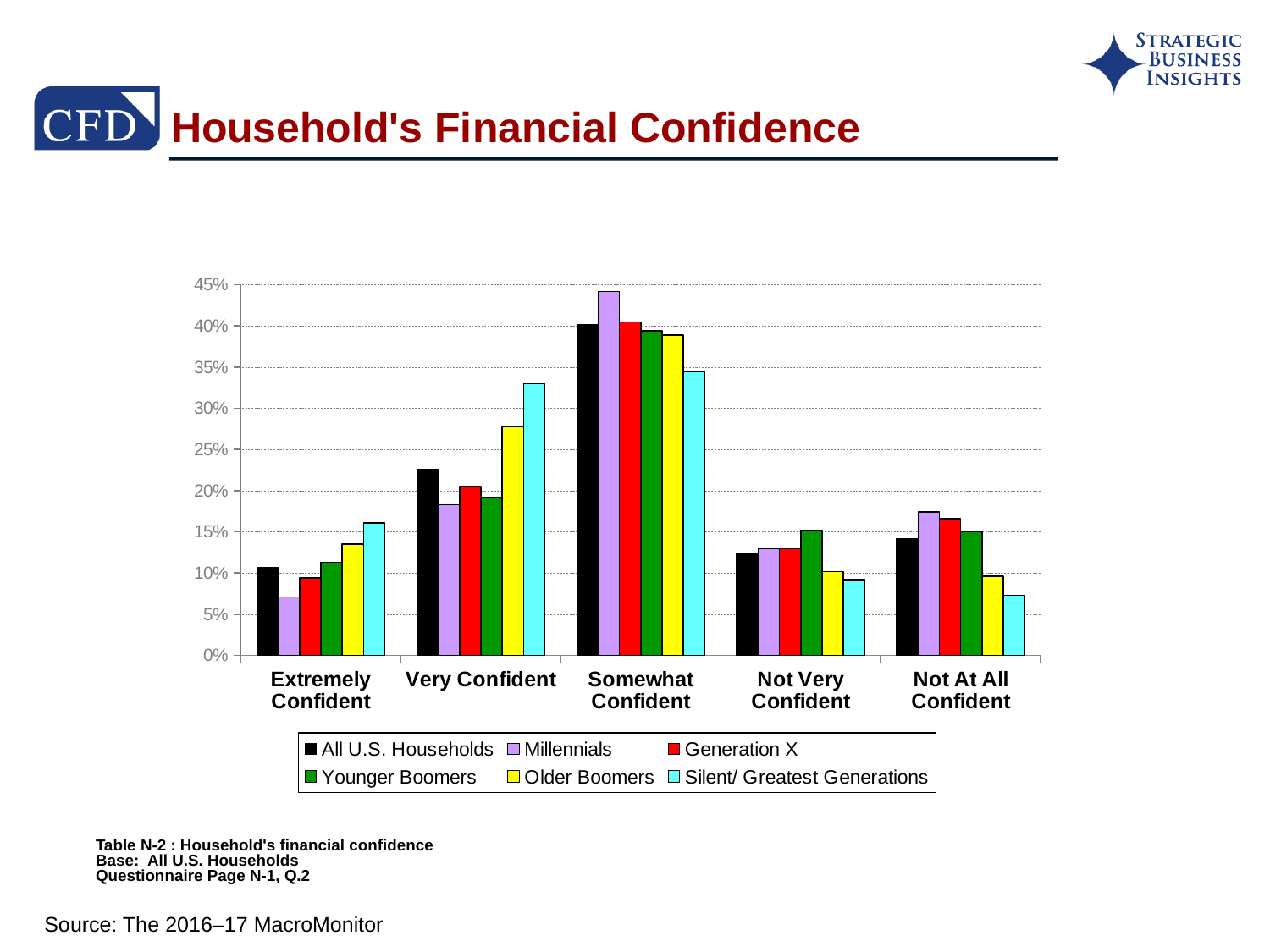
Is the value for Silent/ Greatest Generations in the Very Confident category greater or less than 30%? greater How many series does the legend list? 6 In the Extremely Confident category, which is larger: Older Boomers or Millennials? Older Boomers Which group has the highest value for Somewhat Confident? Millennials Is the value for Millennials in the Somewhat Confident category greater or less than 40%? greater What kind of chart is shown on the slide? bar chart How many confidence categories are shown on the x axis? 5 Which group has the highest value for Very Confident? Silent/ Greatest Generations What is the title of the chart on the slide? Household's Financial Confidence Is the value for Silent/ Greatest Generations in the Not At All Confident category greater or less than 10%? less Which group has the lowest value for Extremely Confident? Millennials Which group has the lowest value for Not At All Confident? Silent/ Greatest Generations